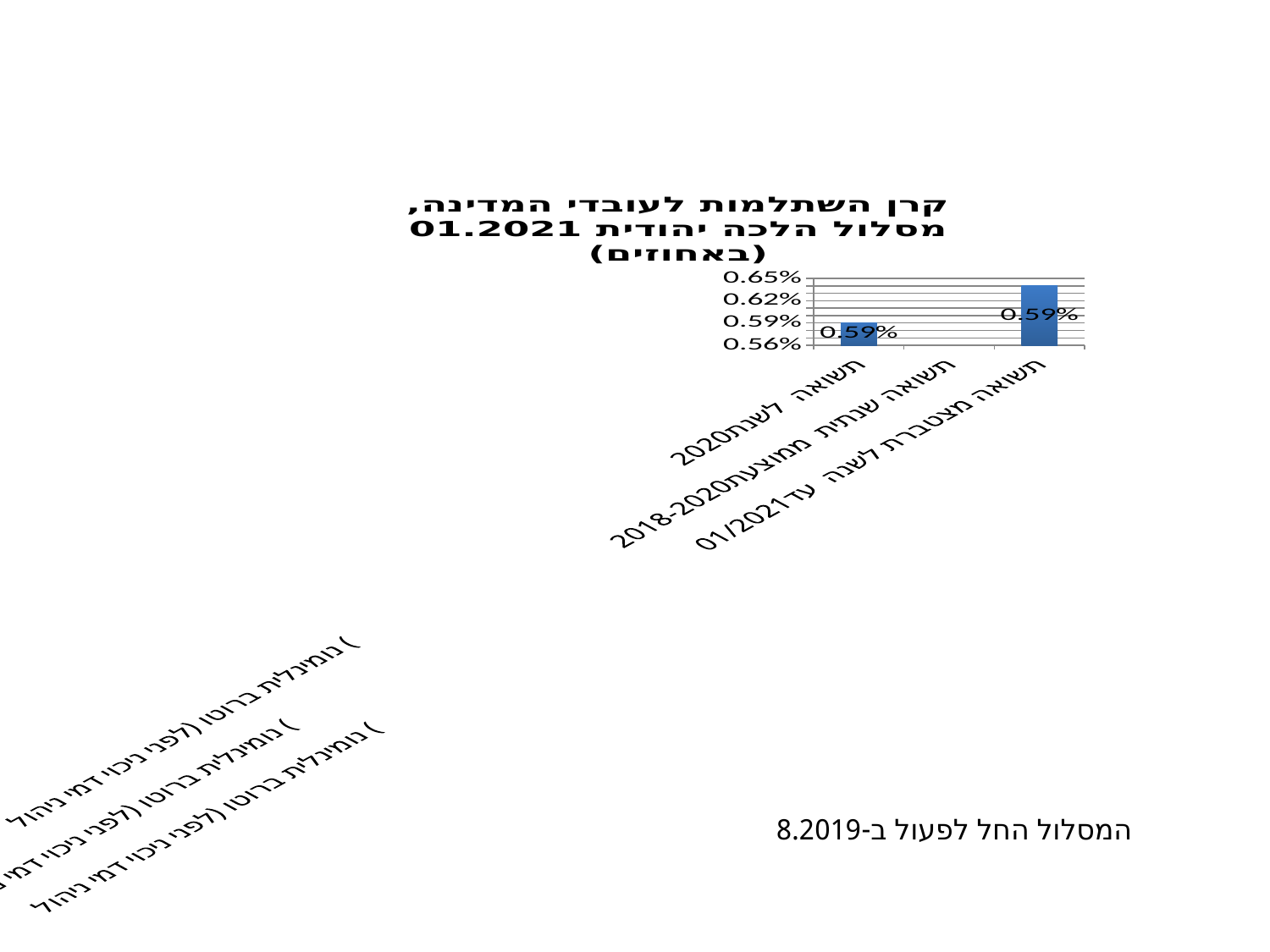
What value is printed on the bar for 'תשואה מצטברת לשנה עד 01/2021'? 0.59% What kind of chart is shown on the slide? bar chart What is the value shown for the category 'תשואה לשנת 2020'? 0.59% Is the value for 'תשואה לשנת 2020' greater or less than 0.56%? greater How many categories are shown on the x axis of the chart? 3 What is the lowest value shown on the chart's vertical axis? 0.56% Is the value for 'תשואה לשנת 2020' greater or less than 0.62%? less What is the highest value shown on the chart's vertical axis? 0.65% Which category on the chart has no visible bar? תשואה שנתית ממוצעת 2018-2020